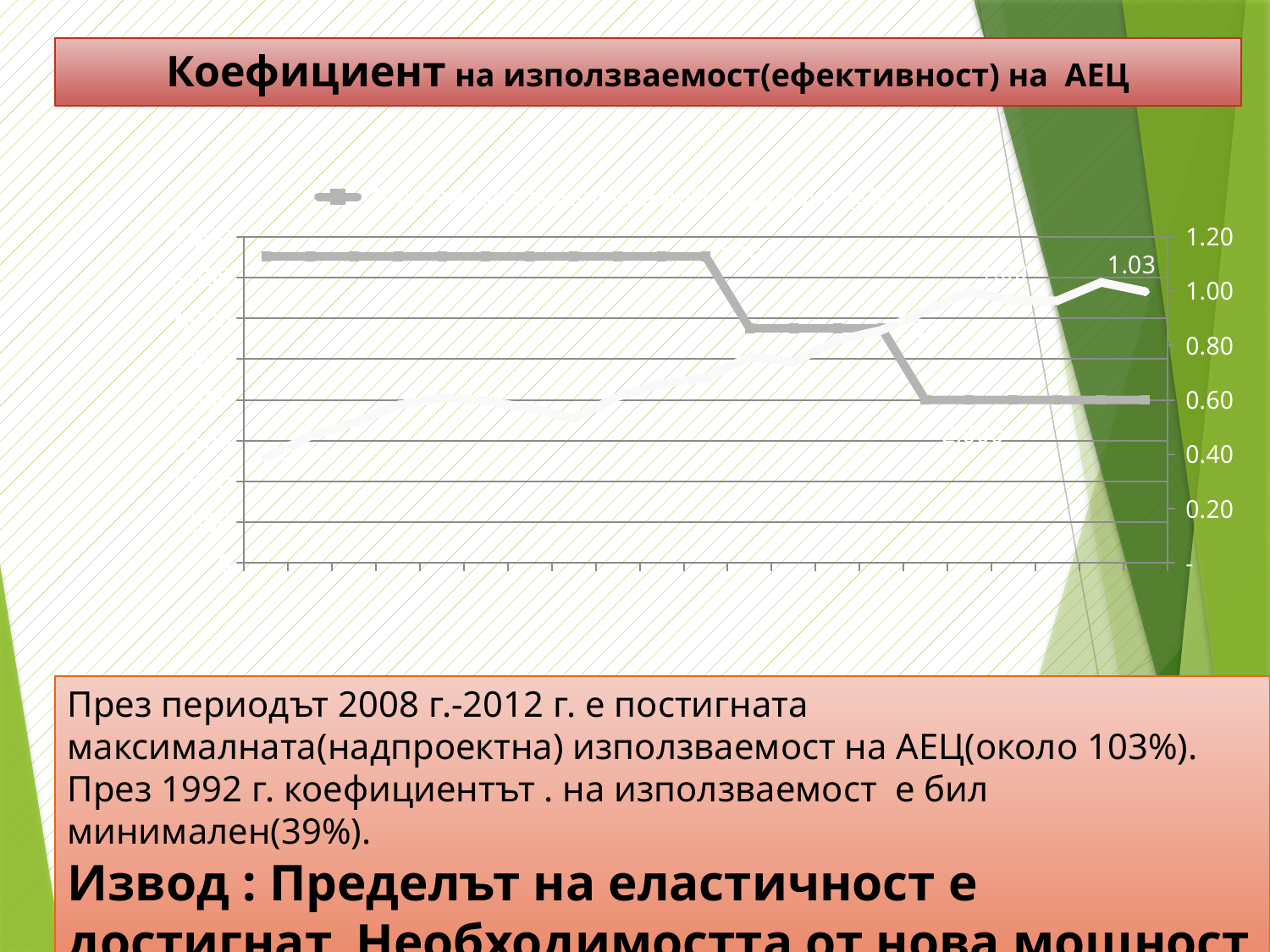
What is the value of the data label printed near the right end of the white line? 1.03 What kind of chart is shown on the slide? line chart Is the value of the white line at the left end of the chart greater or less than 0.60? less Does the grey step line rise or fall from left to right across the chart? falls Is the value of the grey step line at the left end of the chart greater or less than 1.00? greater What is the highest value labelled on the vertical axis? 1.20 What is the title shown at the top of the slide above the chart? Коефициент на използваемост(ефективност) на АЕЦ Does the white line rise or fall overall from left to right across the chart? rises At the right end of the chart, which line is higher, the white line or the grey line? the white line At the left end of the chart, which line is higher, the white line or the grey line? the grey line